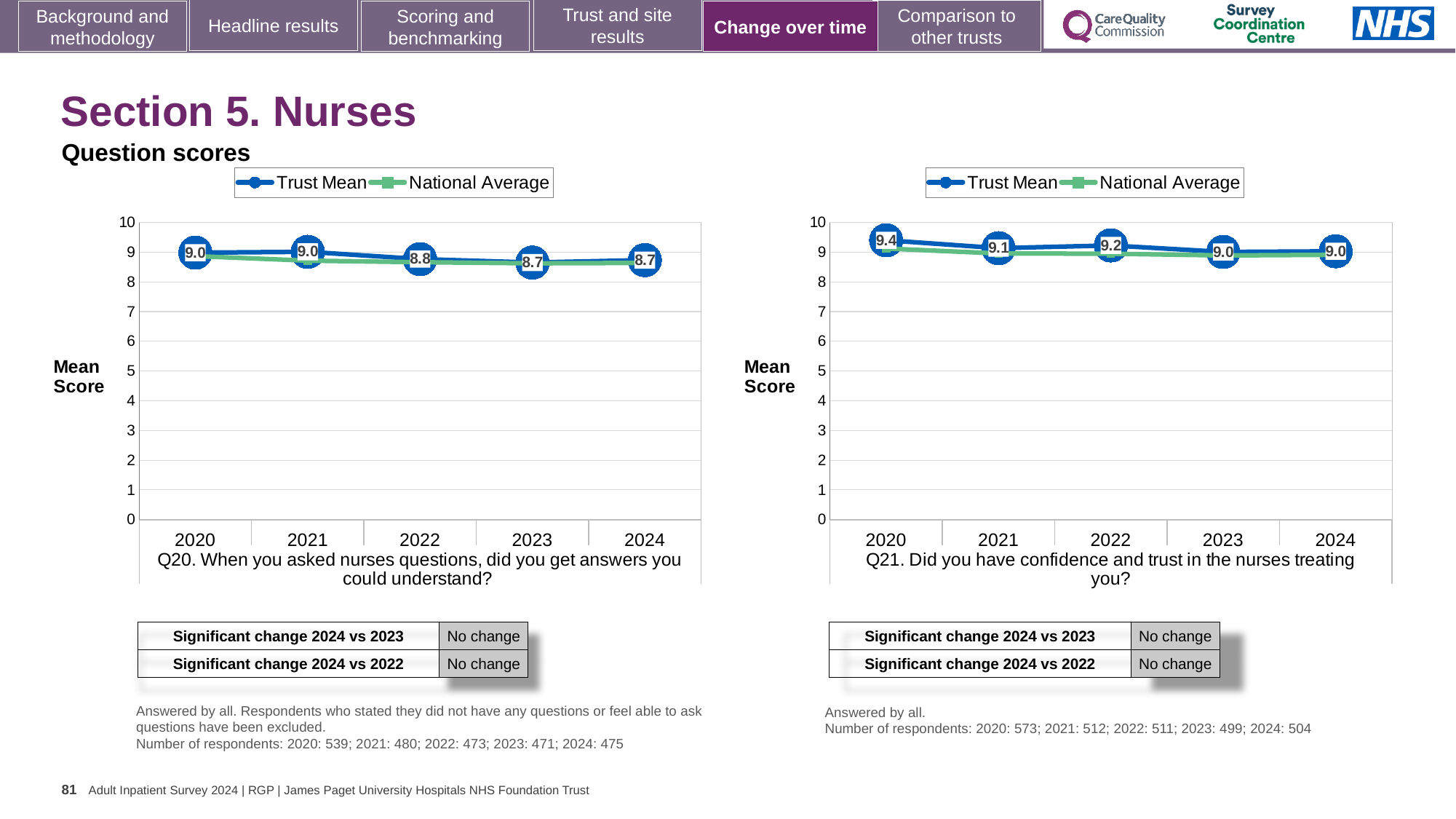
In the Q20 chart, what is the Trust Mean score for 2022? 8.8 How many years are shown on the x axis of the Q20 chart? 5 In the Q21 chart, which year has the larger Trust Mean score, 2021 or 2022? 2022 In the Q21 chart, what is the Trust Mean score for 2020? 9.4 How many series does the legend of the Q21 chart list? 2 In the Q20 chart, what is the difference between the Trust Mean scores for 2020 and 2024? 0.3 In the Q21 chart, what is the Trust Mean score for 2023? 9.0 In the Q21 chart, which year has the highest Trust Mean score? 2020 In the Q21 chart, what is the difference between the Trust Mean scores for 2020 and 2024? 0.4 In the Q20 chart, does the Trust Mean score rise or fall from 2020 to 2024? Fall What type of chart is used for Q20? Line chart In the Q20 chart, is the National Average value for 2024 greater or less than 8? greater